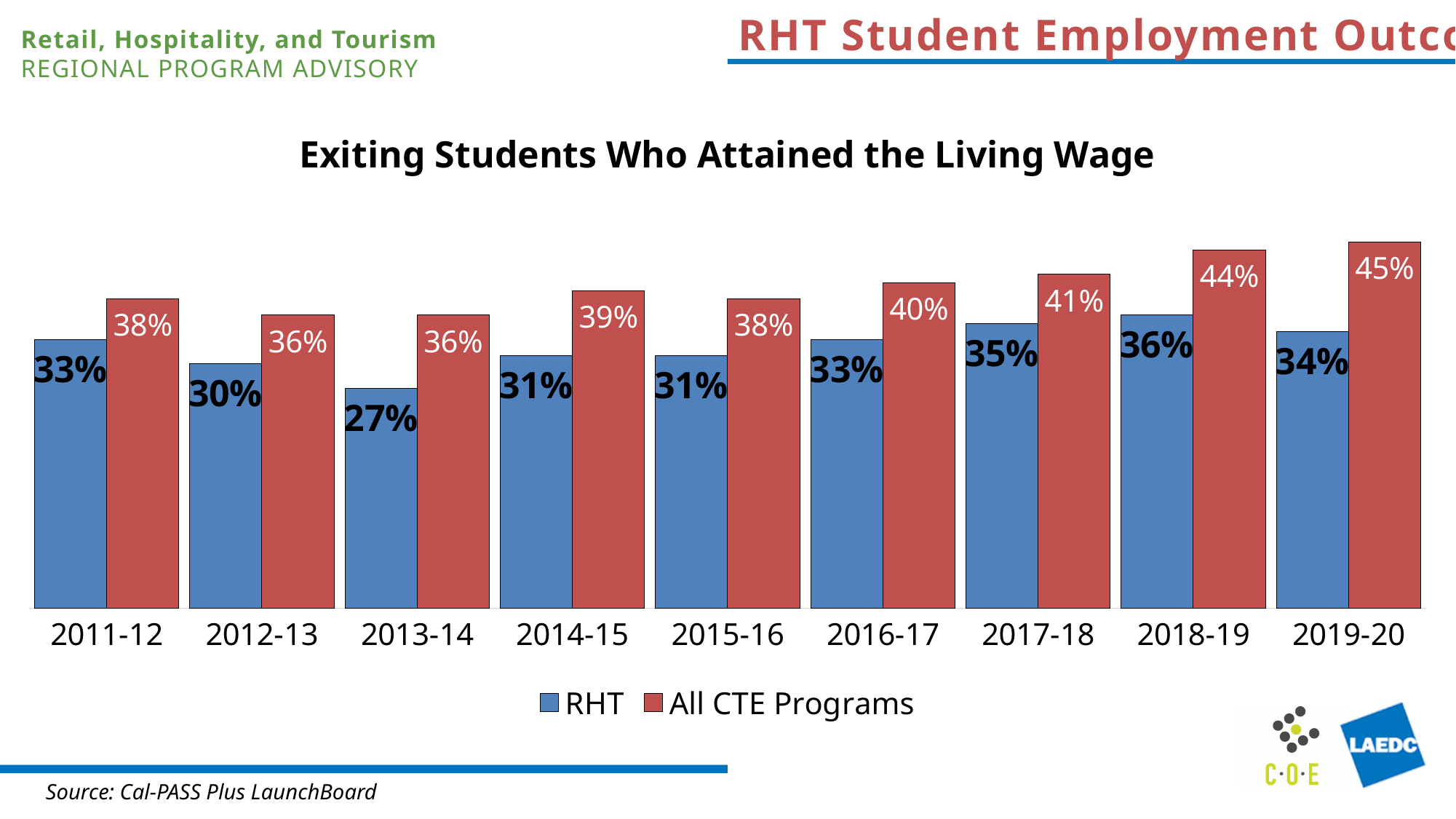
What is the RHT value for 2017-18? 35% Does the All CTE Programs value rise or fall from 2015-16 to 2019-20? Rise How many years are shown on the x axis? 9 How many series does the legend list? 2 What percentage of RHT exiting students attained the living wage in 2013-14? 27% What is the value for All CTE Programs in 2019-20? 45% Which is larger in 2014-15, the RHT value or the All CTE Programs value? All CTE Programs In which year is the All CTE Programs value the lowest? 2012-13 and 2013-14 In which year is the RHT value the highest? 2018-19 What kind of chart is shown on the slide? Bar chart What is the difference between All CTE Programs and RHT in 2019-20? 11 percentage points What is the title of the chart? Exiting Students Who Attained the Living Wage